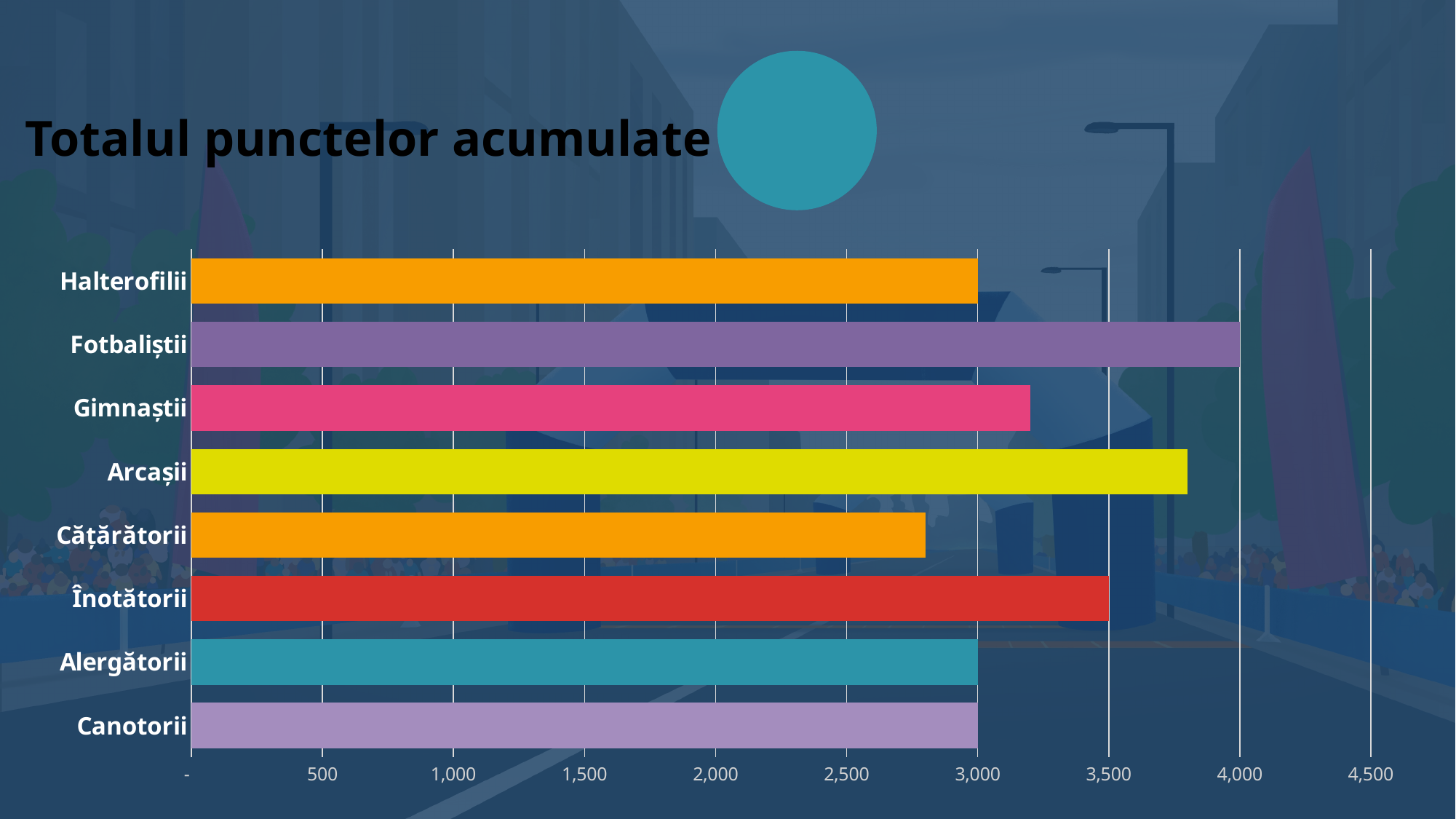
What is the difference between the values for Fotbaliștii and Înotătorii? 500 What is the value for Fotbaliștii? 4,000 Is the value for Arcașii greater or less than 3,500? greater What is the title of the chart? Totalul punctelor acumulate Is the value for Cățărătorii greater or less than 3,000? less Which category has the lowest value? Cățărătorii What kind of chart is shown on the slide? bar chart Which is larger, the value for Gimnaștii or the value for Canotorii? Gimnaștii What is the value for Înotătorii? 3,500 How many categories are plotted in the chart? 8 Which category has the highest value? Fotbaliștii What is the value for Alergătorii? 3,000